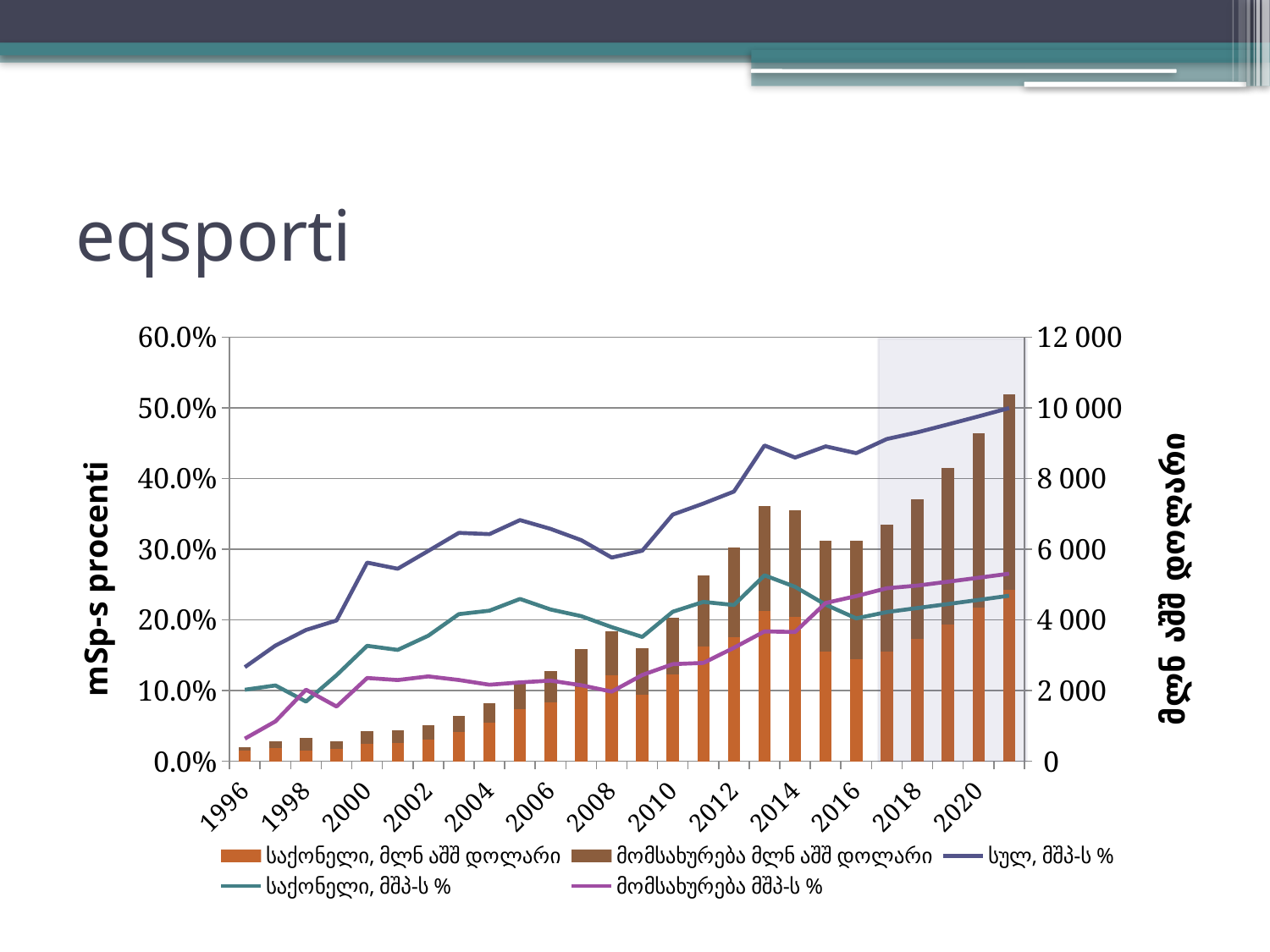
Is the total height of the stacked bar for 2008 greater or less than 4 000? less Do the stacked bars generally rise or fall from 1996 to 2020? rise What is the label of the left vertical axis? mSp-s procenti Is the 'სულ, მშპ-ს %' line higher in 2012 or in 2008? 2012 What is the title of the slide chart? eqsporti Is the value of the 'სულ, მშპ-ს %' line in 2020 greater or less than 40%? greater What kind of chart is shown on the slide? A combined bar and line chart (stacked bars with lines) Is the value of the 'სულ, მშპ-ს %' line in 1996 greater or less than 20%? less Which labeled year has the lowest stacked bar (total exports in mln USD)? 1996 How many series does the legend list? 5